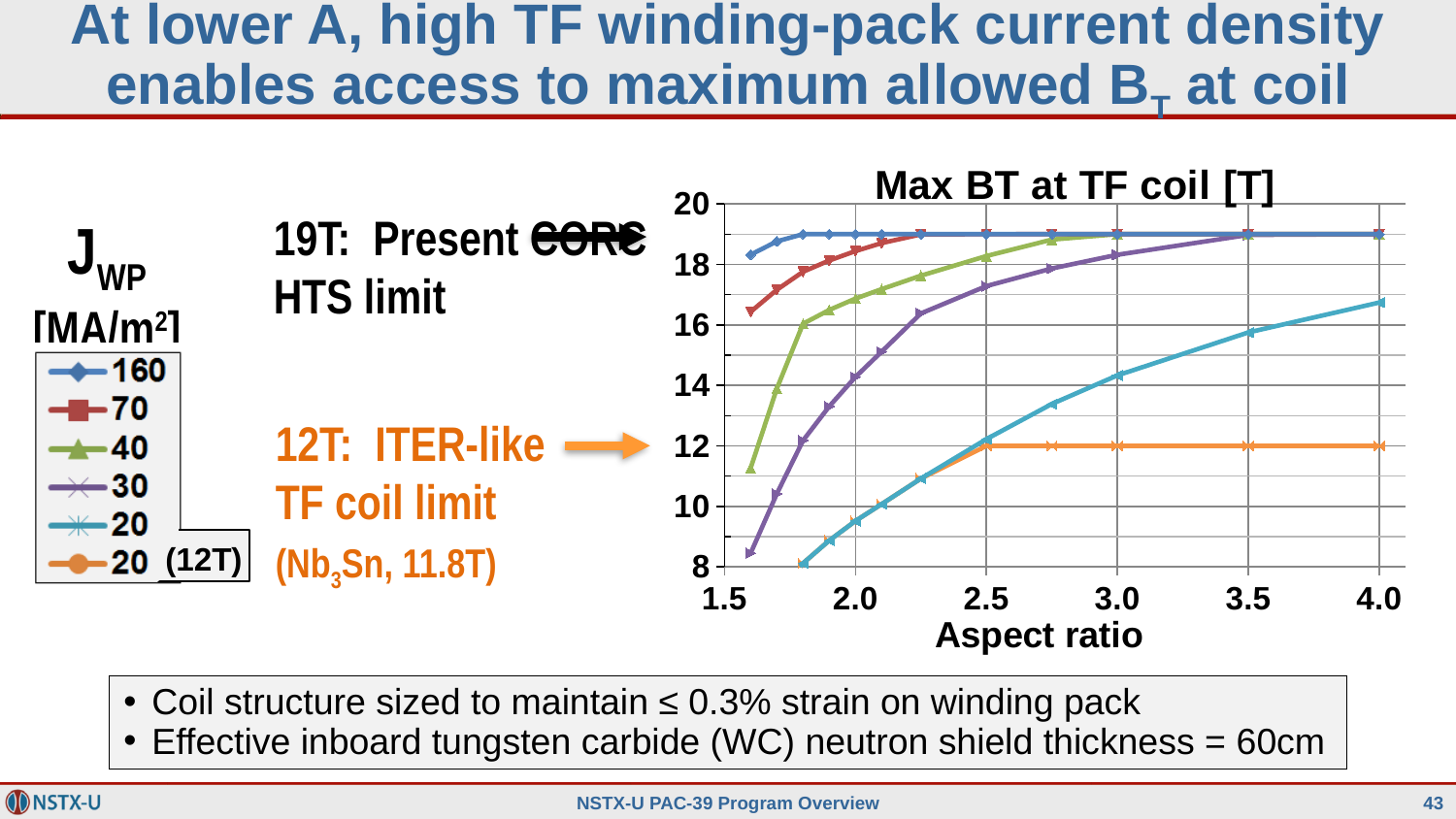
Does the value of the 20 series rise or fall as aspect ratio increases? rise What is the value of the 20 (12T) series at aspect ratio 4.0? 12 Is the value of the 30 series at aspect ratio 1.6 greater or less than 10? less What is the label of the x axis of the chart? Aspect ratio How many series does the chart legend list? 6 What type of chart is shown on the slide? line chart Which series has the highest value at aspect ratio 1.6? 160 Is the value of the 160 series at aspect ratio 1.6 greater or less than 18? greater At aspect ratio 2.0, which series has the larger value, 70 or 40? 70 Is the value of the 20 series at aspect ratio 4.0 greater or less than 16? greater Which series has the lowest value at aspect ratio 4.0? 20 (12T) What is the title of the chart? Max BT at TF coil [T]